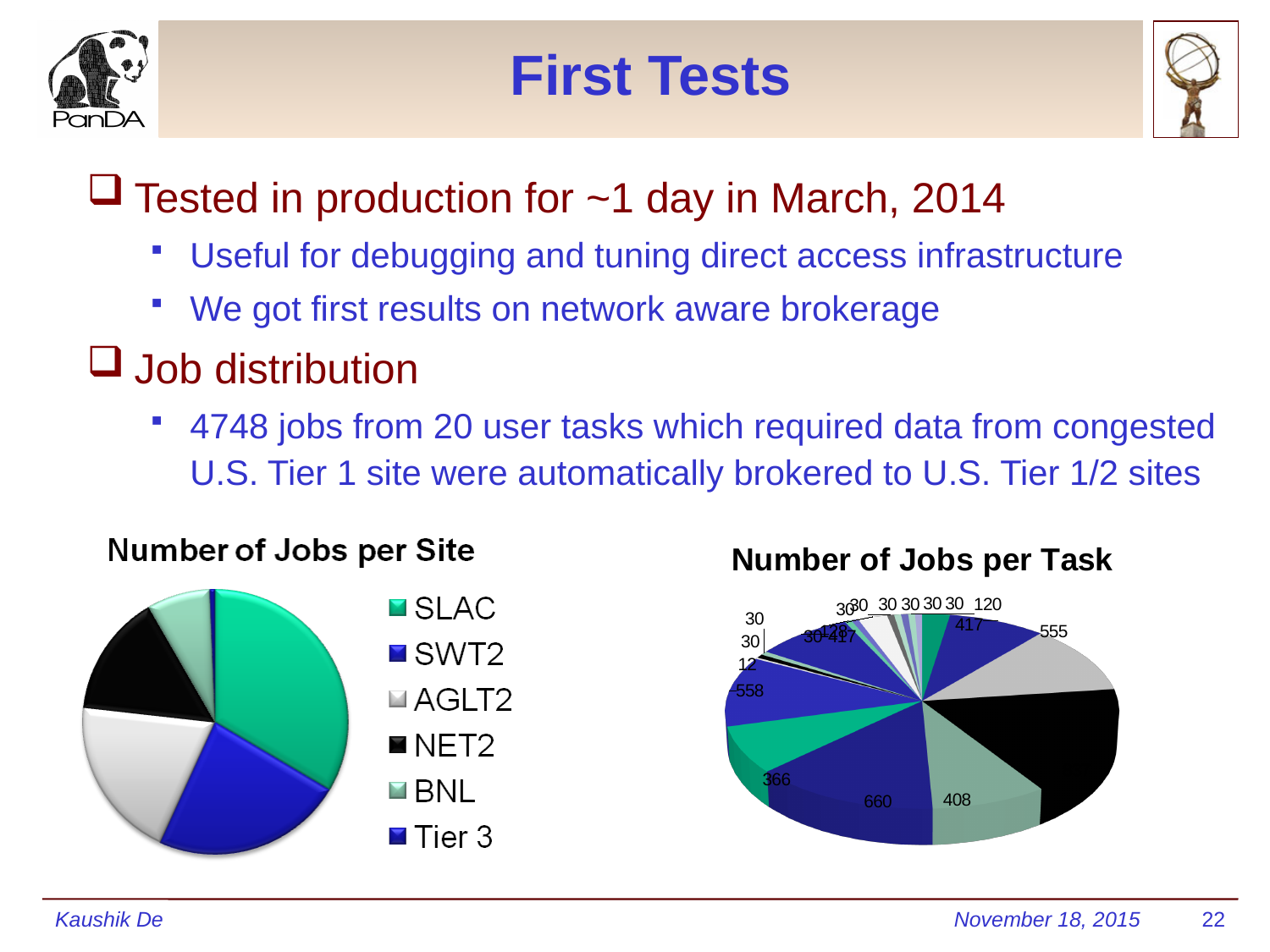
What kind of chart is the "Number of Jobs per Task" chart? pie chart In the "Number of Jobs per Site" chart, which slice is larger, SWT2 or BNL? SWT2 In the "Number of Jobs per Site" chart, which slice is larger, SLAC or NET2? SLAC In the "Number of Jobs per Task" chart, what is the difference between the slices labeled 660 and 408? 252 In the "Number of Jobs per Site" chart, which site has the largest slice? SLAC In the "Number of Jobs per Task" chart, what is the smallest labeled value? 12 In the "Number of Jobs per Task" chart, what is the difference between the slices labeled 555 and 417? 138 In the "Number of Jobs per Site" chart, which site has the smallest slice? Tier 3 How many entries does the legend of the "Number of Jobs per Site" chart list? 6 What kind of chart is the "Number of Jobs per Site" chart? pie chart In the "Number of Jobs per Task" chart, what is the largest labeled value? 660 What is the title of the chart on the right side of the slide? Number of Jobs per Task